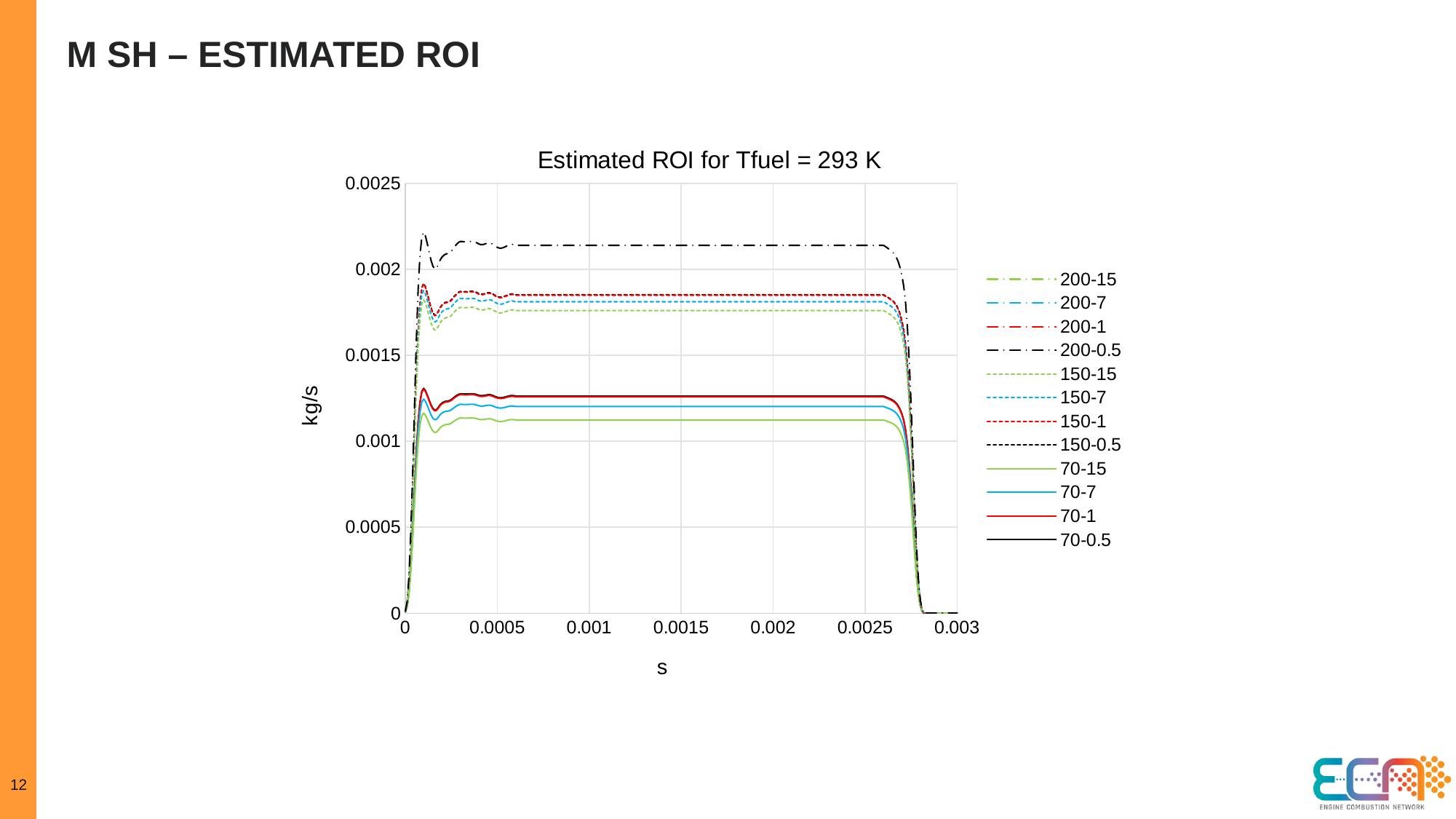
What is the label of the y axis? kg/s What is the title of the chart? Estimated ROI for Tfuel = 293 K Which series has a higher plateau value, 200-1 or 70-1? 200-1 Do the series values rise or fall between 0.0025 s and 0.003 s on the x axis? fall Is the plateau value of the 70-15 series greater or less than 0.0015? less What type of chart is shown on the slide? line chart Is the plateau value of the 70-1 series greater or less than 0.001? greater Is the plateau value of the 200-0.5 series greater or less than 0.002? greater How many series does the legend list? 12 Which series has the lowest plateau value? 70-15 Which series has the highest plateau value? 200-0.5